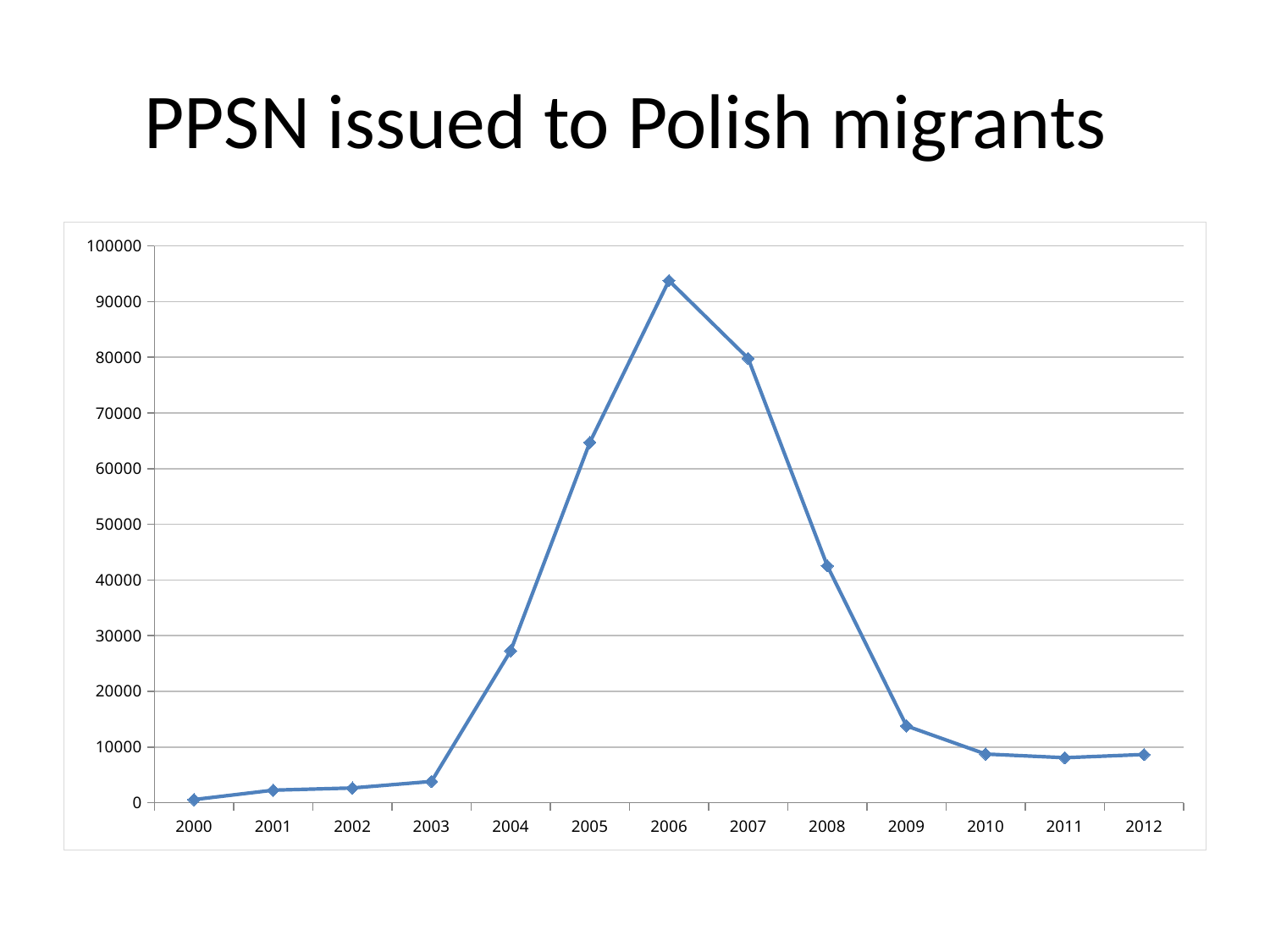
Do the values rise or fall from 2006 to 2011? fall Is the value for 2004 greater or less than 30000? less Is the value for 2009 greater or less than 10000? greater Which year has the larger value, 2007 or 2008? 2007 Which year has the highest value? 2006 Is the value for 2008 greater or less than 50000? less What is the title of the chart? PPSN issued to Polish migrants How many years are plotted on the x axis? 13 What kind of chart is shown on the slide? line chart Which year has the lowest value? 2000